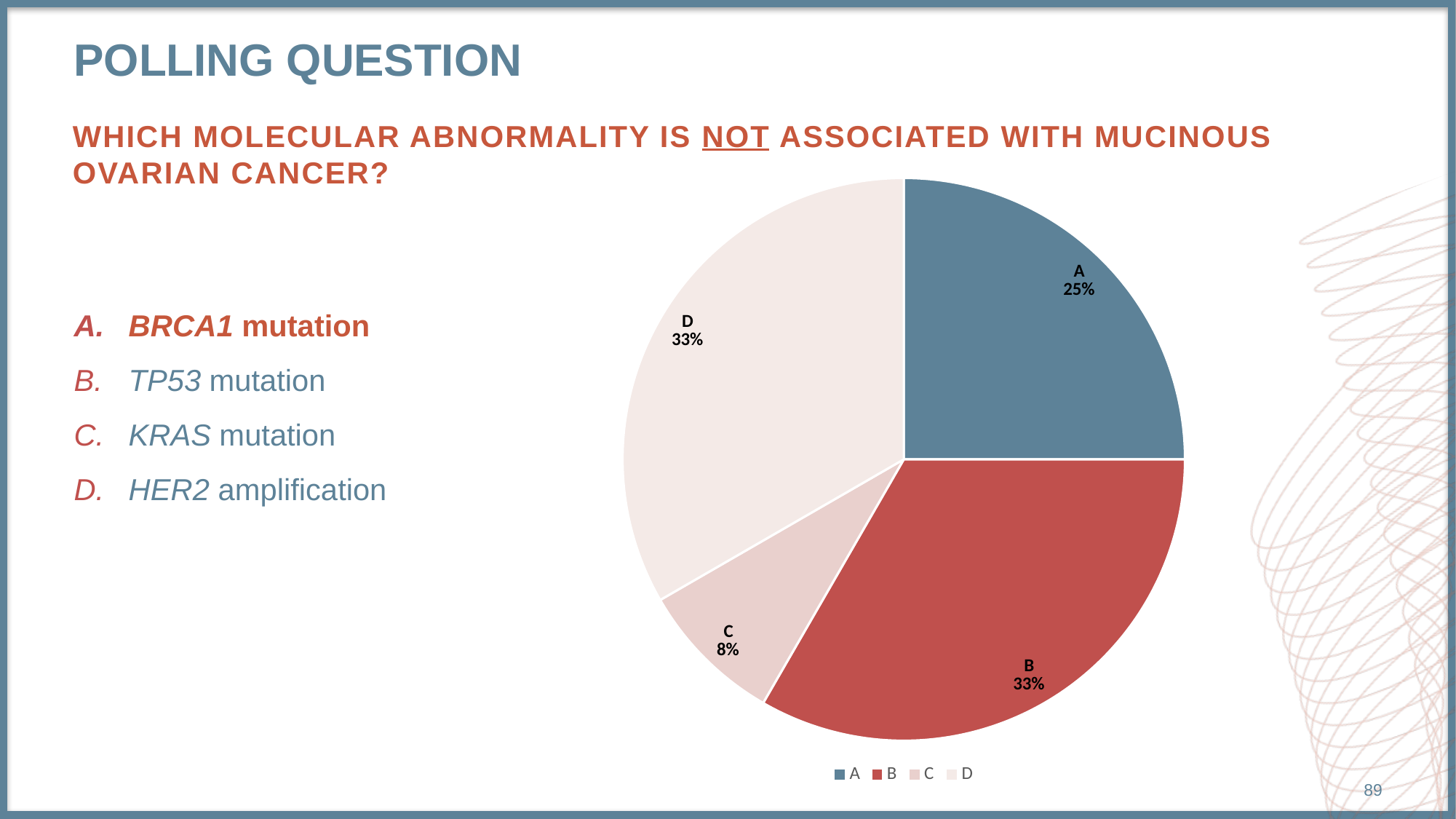
Which is larger in the pie chart, slice B or slice A? B Which is larger in the pie chart, slice A or slice C? A What kind of chart is shown on the slide? Pie chart What percentage of the pie chart is slice C? 8% How many entries does the legend of the pie chart list? 4 Which slice of the pie chart is the smallest? C What percentage of the pie chart is slice A? 25% What percentage of the pie chart is slice D? 33% What percentage of the pie chart is slice B? 33% What is the difference in percentage points between slice A and slice C? 17% What is the difference in percentage points between slice D and slice C? 25% How many slices does the pie chart have? 4